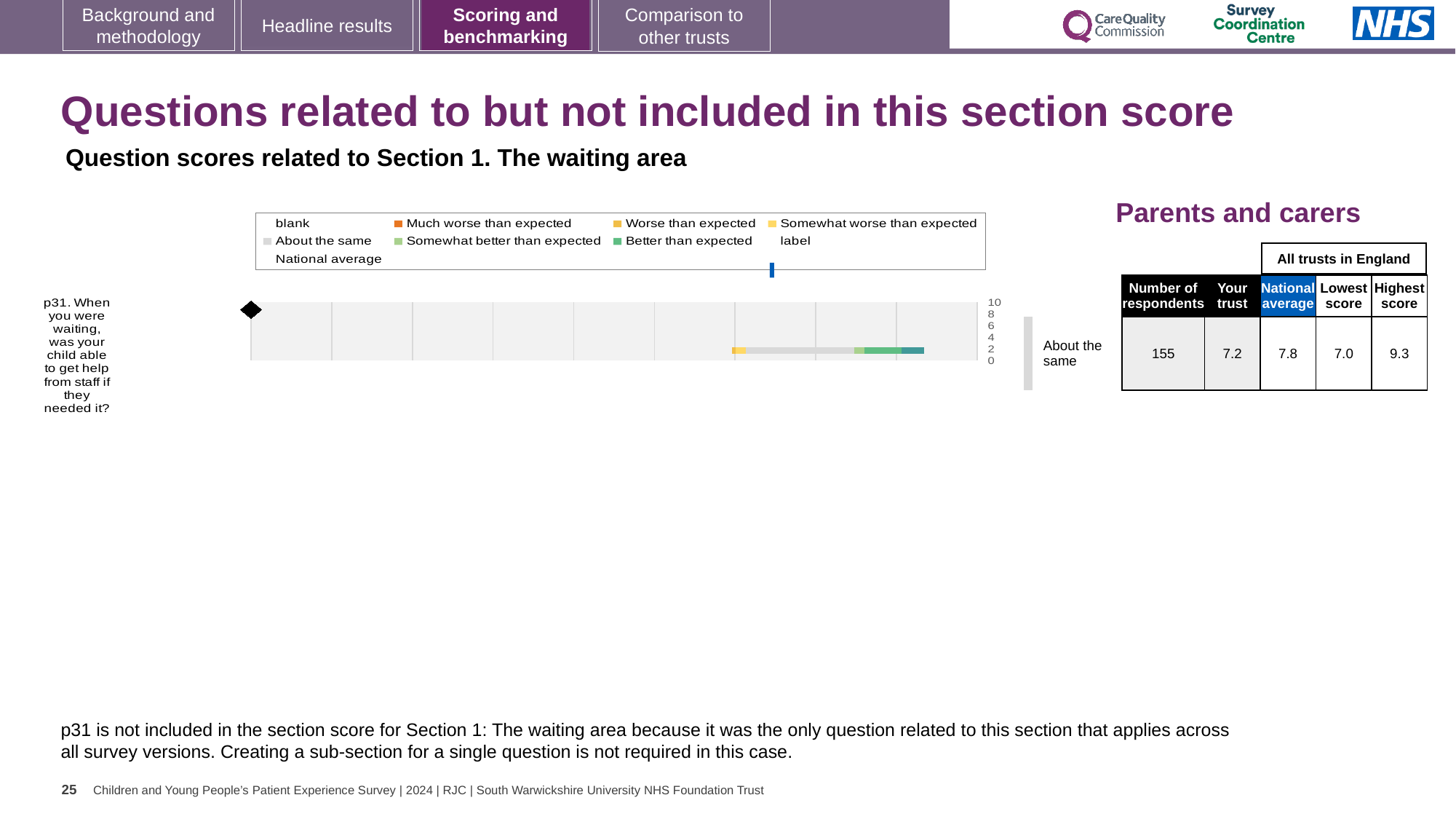
What kind of chart is used to show the p31 question score? bar chart Which respondent group does the chart relate to, according to the heading above the table? Parents and carers What is the difference between the highest and lowest scores among all trusts in England for p31? 2.3 How many questions are plotted in the chart? 1 What is the lowest score among all trusts in England for p31? 7.0 Which is larger for p31, the 'Your trust' score or the national average? National average How many respondents answered p31? 155 What benchmark category is shown next to the chart for p31? About the same What is the national average score for p31? 7.8 What is the difference between the national average and the 'Your trust' score for p31? 0.6 What is the highest score among all trusts in England for p31? 9.3 What is the 'Your trust' score for p31? 7.2